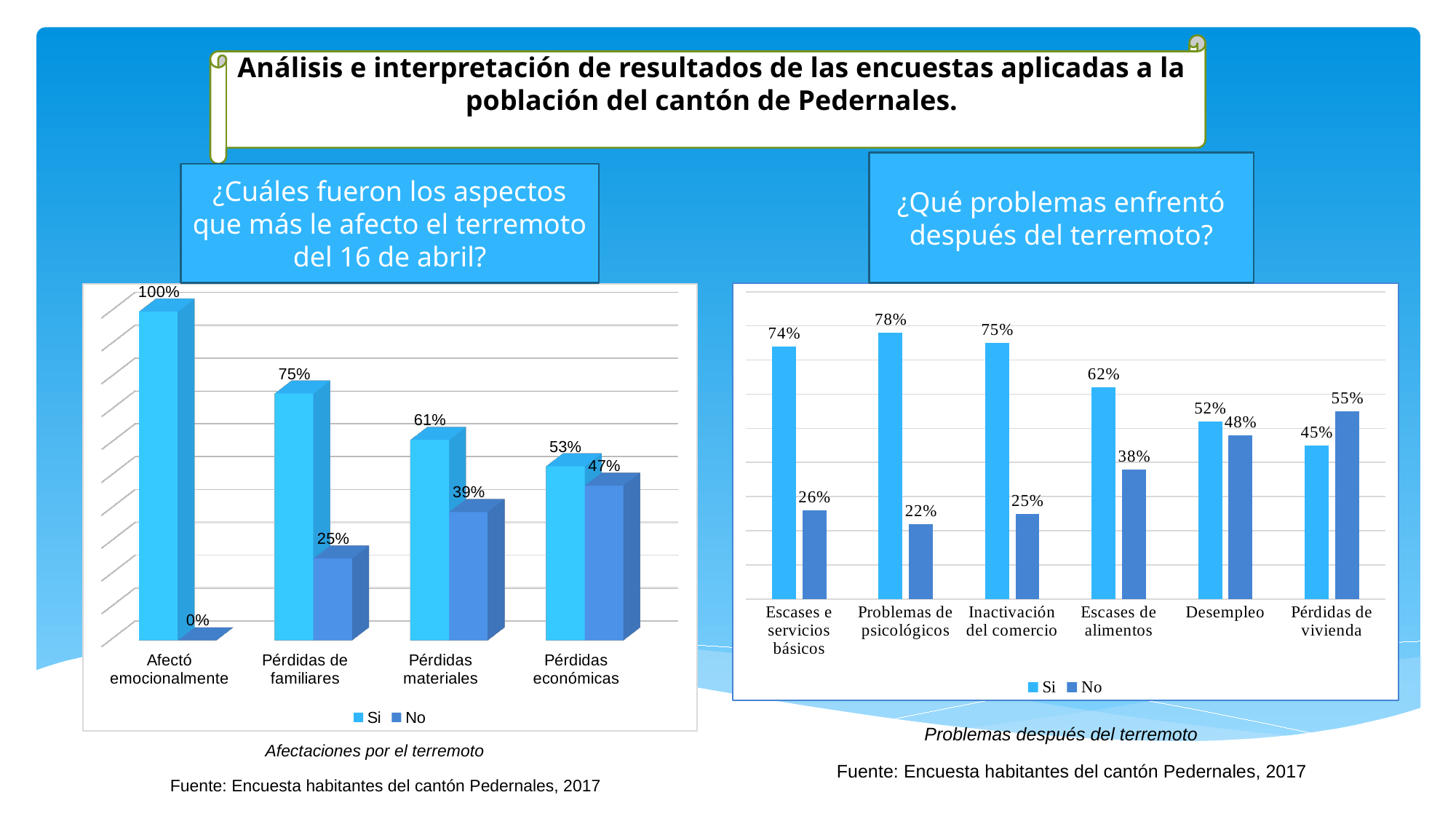
In the right chart (Problemas después del terremoto), is the 'Si' value or the 'No' value larger for 'Pérdidas de vivienda'? No In the right chart (Problemas después del terremoto), what is the 'No' value for 'Escases de alimentos'? 38% In the left chart (Afectaciones por el terremoto), which category has the lowest 'Si' value? Pérdidas económicas In the left chart (Afectaciones por el terremoto), what is the 'Si' value for 'Afectó emocionalmente'? 100% In the right chart (Problemas después del terremoto), what is the 'Si' value for 'Inactivación del comercio'? 75% In the right chart (Problemas después del terremoto), which category has the lowest 'No' value? Problemas de psicológicos In the right chart (Problemas después del terremoto), which category has the highest 'Si' value? Problemas de psicológicos What type of chart is the right chart (Problemas después del terremoto)? Bar chart In the left chart (Afectaciones por el terremoto), what is the difference between the 'Si' and 'No' values for 'Pérdidas de familiares'? 50% In the right chart (Problemas después del terremoto), how many series does the legend list? 2 In the left chart (Afectaciones por el terremoto), how many categories are shown on the x axis? 4 In the left chart (Afectaciones por el terremoto), what is the 'No' value for 'Pérdidas materiales'? 39%